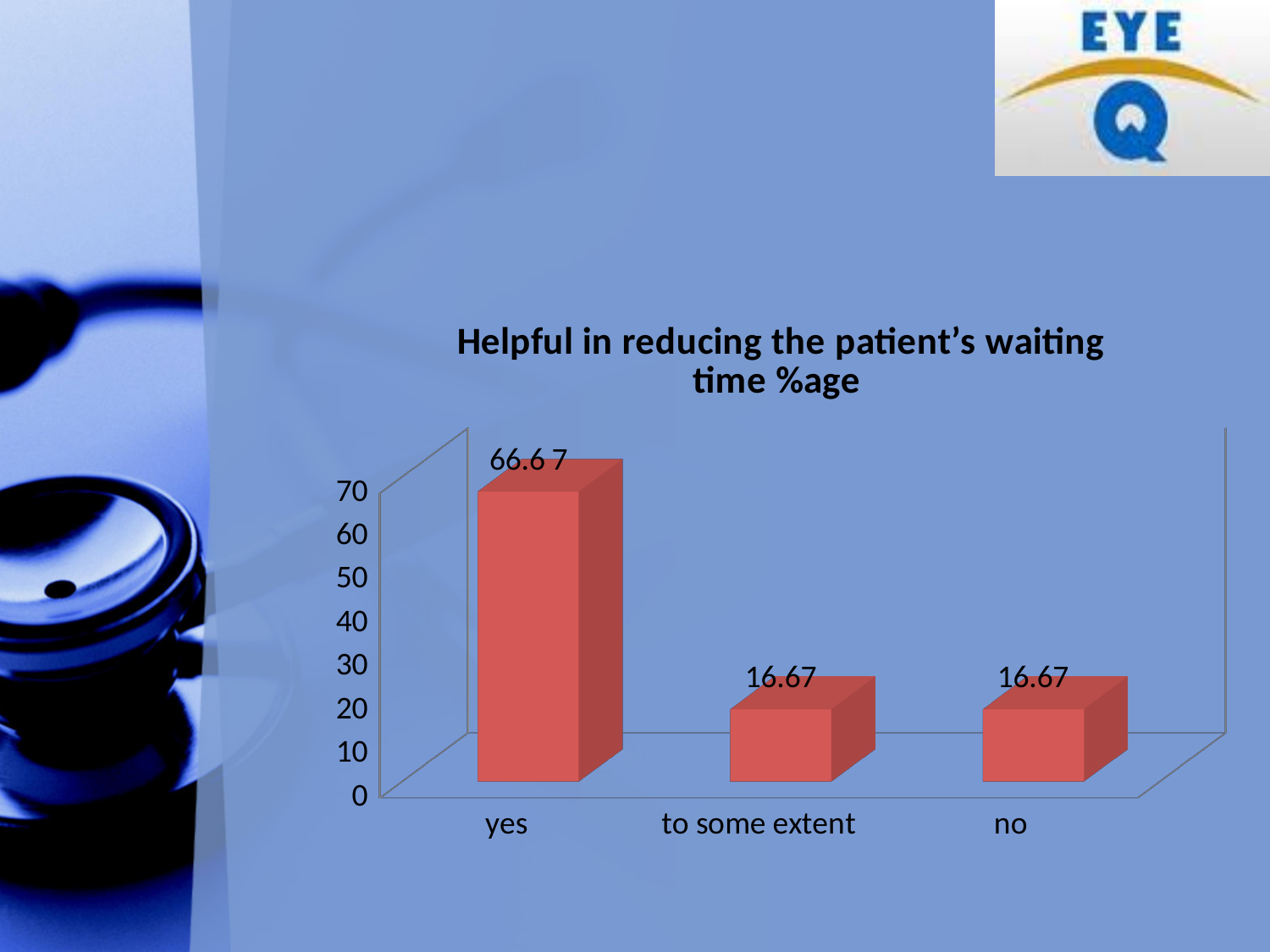
Is the value for "yes" greater or less than 50? greater What is the value for "to some extent"? 16.67 What kind of chart is shown on the slide? bar chart What is the difference between the values for "yes" and "no"? 50 What is the value for "no"? 16.67 Which is larger, the value for "yes" or the value for "to some extent"? yes How many categories are shown on the x axis? 3 Is the value for "no" greater or less than 20? less What is the value for "yes"? 66.67 What colour are the bars in the chart? red What is the title of the chart? Helpful in reducing the patient's waiting time %age Which category has the highest value? yes